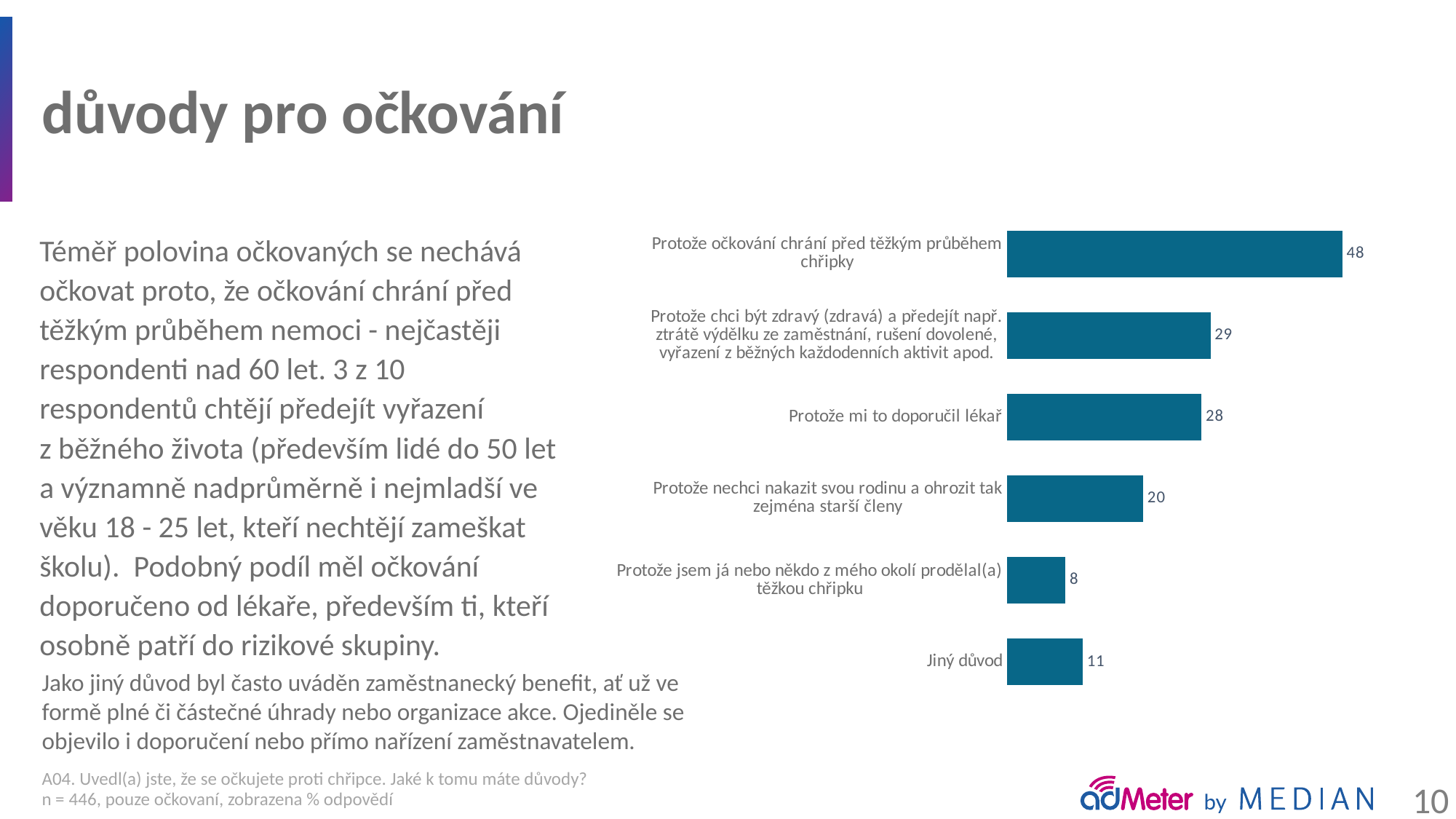
Which category has the highest value? Protože očkování chrání před těžkým průběhem chřipky What kind of chart is shown on the slide? bar chart What is the value for "Protože nechci nakazit svou rodinu a ohrozit tak zejména starší členy"? 20 What is the difference between the value for "Protože očkování chrání před těžkým průběhem chřipky" and the value for "Protože mi to doporučil lékař"? 20 Which is larger: the value for "Protože nechci nakazit svou rodinu a ohrozit tak zejména starší členy" or the value for "Jiný důvod"? Protože nechci nakazit svou rodinu a ohrozit tak zejména starší členy What is the difference between the value for "Jiný důvod" and the value for "Protože jsem já nebo někdo z mého okolí prodělal(a) těžkou chřipku"? 3 What is the value for "Protože očkování chrání před těžkým průběhem chřipky"? 48 What is the title of the slide? důvody pro očkování What is the value for "Jiný důvod"? 11 Which category has the lowest value? Protože jsem já nebo někdo z mého okolí prodělal(a) těžkou chřipku How many categories does the chart show? 6 What is the value for "Protože mi to doporučil lékař"? 28